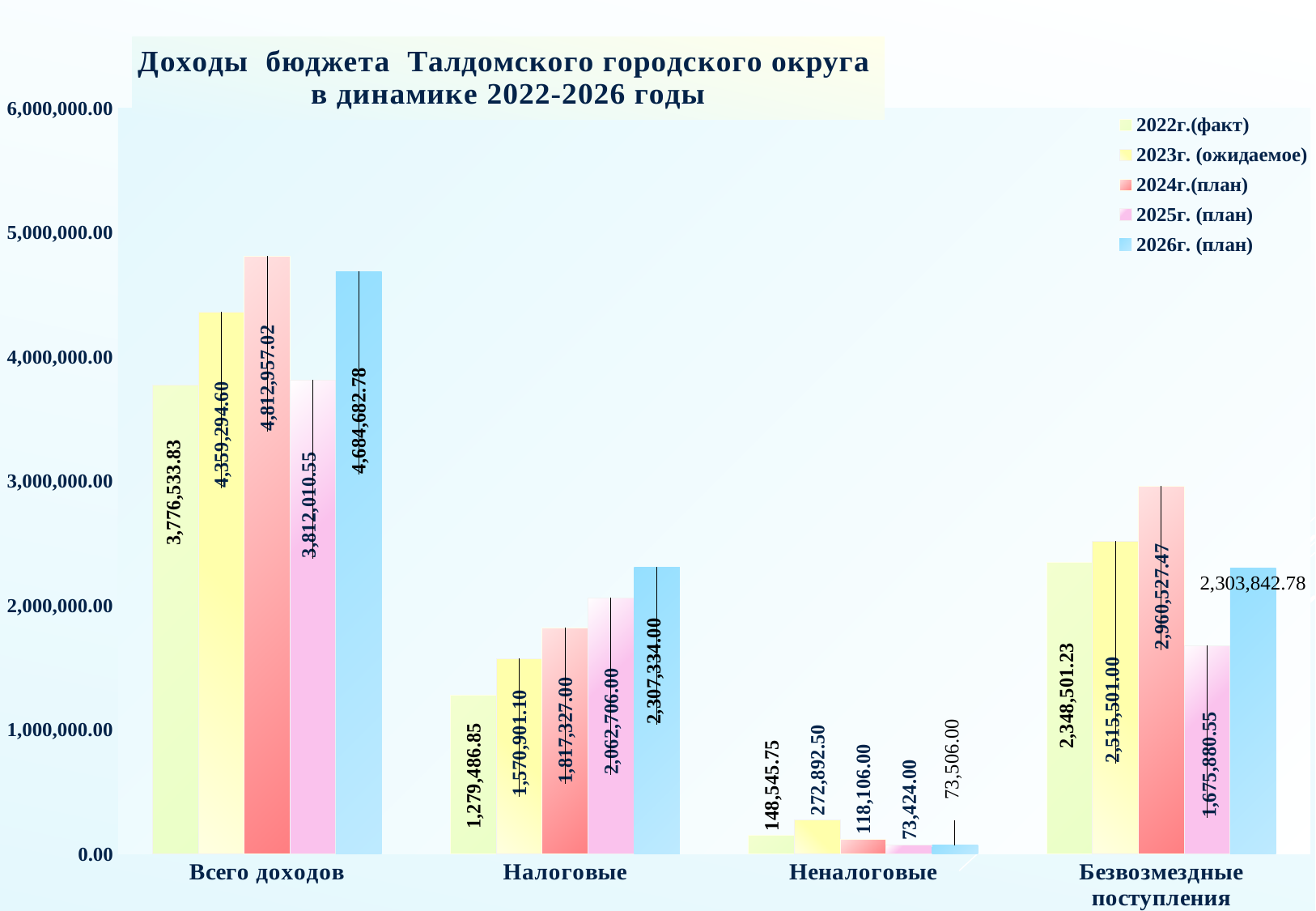
What is the value for 2022г.(факт) in the Всего доходов category? 3,776,533.83 What is the difference between the 2024г.(план) and 2022г.(факт) values in the Безвозмездные поступления category? 612,026.24 What kind of chart is shown on the slide? bar chart Which year has the highest value in the Всего доходов category? 2024г.(план) What is the value for 2026г. (план) in the Налоговые category? 2,307,334.00 What is the value for 2023г. (ожидаемое) in the Неналоговые category? 272,892.50 Do the Налоговые values rise or fall from 2022 to 2026? rise Which is larger in the Неналоговые category: the 2022г.(факт) value or the 2024г.(план) value? 2022г.(факт) What is the value for 2025г. (план) in the Безвозмездные поступления category? 1,675,880.55 Which year has the lowest value in the Налоговые category? 2022г.(факт) How many series does the legend list? 5 How many categories are shown on the x axis? 4